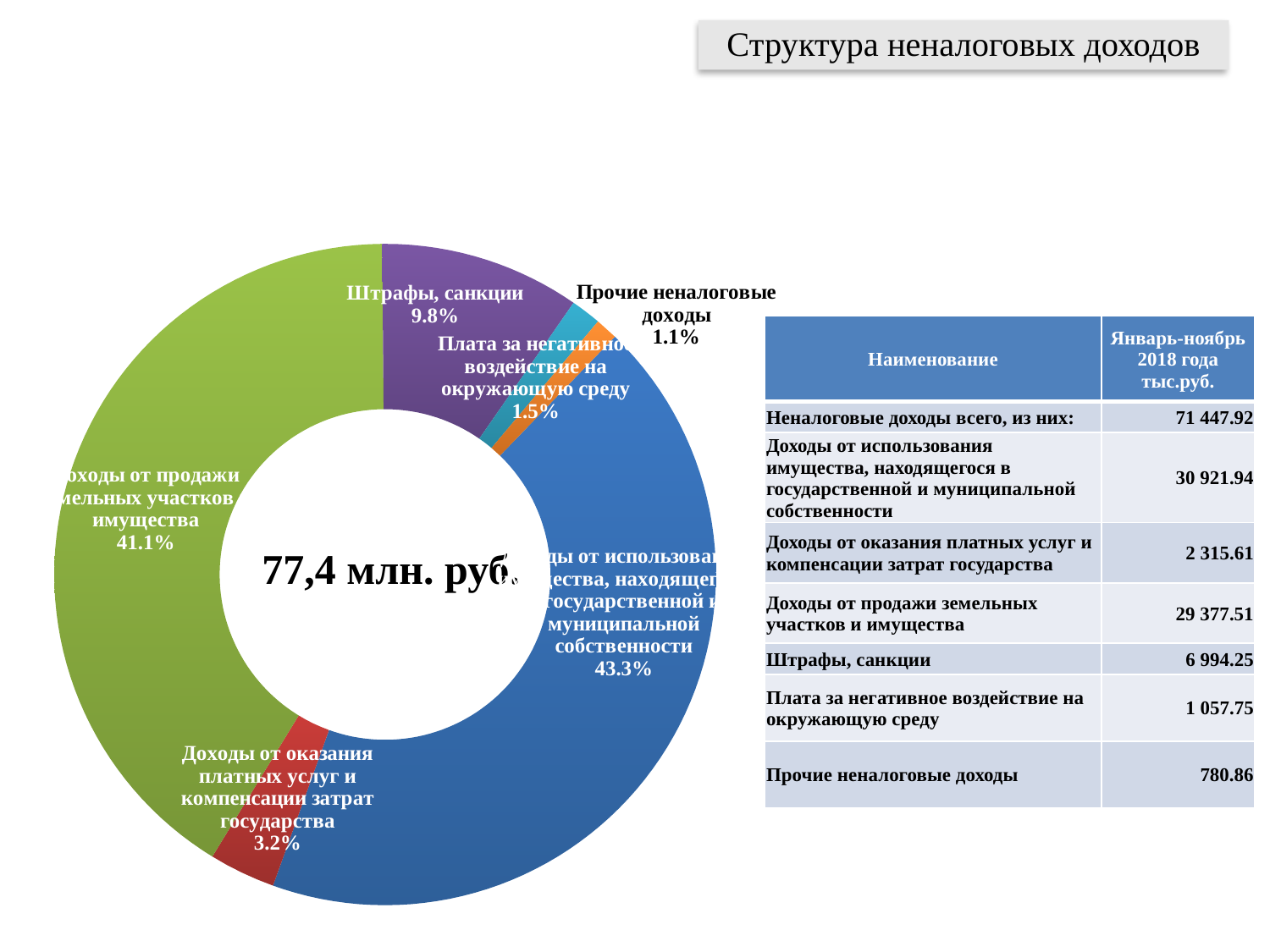
What total value is printed in the centre of the doughnut chart? 77,4 млн. руб. What kind of chart is shown on the slide? Doughnut (pie) chart Which share is larger in the chart: "Доходы от продажи земельных участков и имущества" or "Штрафы, санкции"? Доходы от продажи земельных участков и имущества What percentage is shown for "Доходы от оказания платных услуг и компенсации затрат государства" in the chart? 3.2% How many categories (slices) does the doughnut chart contain? 6 Which category has the largest share in the doughnut chart? Доходы от использования имущества, находящегося в государственной и муниципальной собственности (43.3%) What share of the doughnut chart is labelled for "Штрафы, санкции"? 9.8% What is the title shown at the top of the slide? Структура неналоговых доходов What percentage is shown for "Плата за негативное воздействие на окружающую среду" in the chart? 1.5% Which category has the smallest share in the doughnut chart? Прочие неналоговые доходы (1.1%) What percentage is shown for "Прочие неналоговые доходы" in the chart? 1.1% By how many percentage points does the share of "Штрафы, санкции" exceed the share of "Доходы от оказания платных услуг и компенсации затрат государства"? 6.6 percentage points